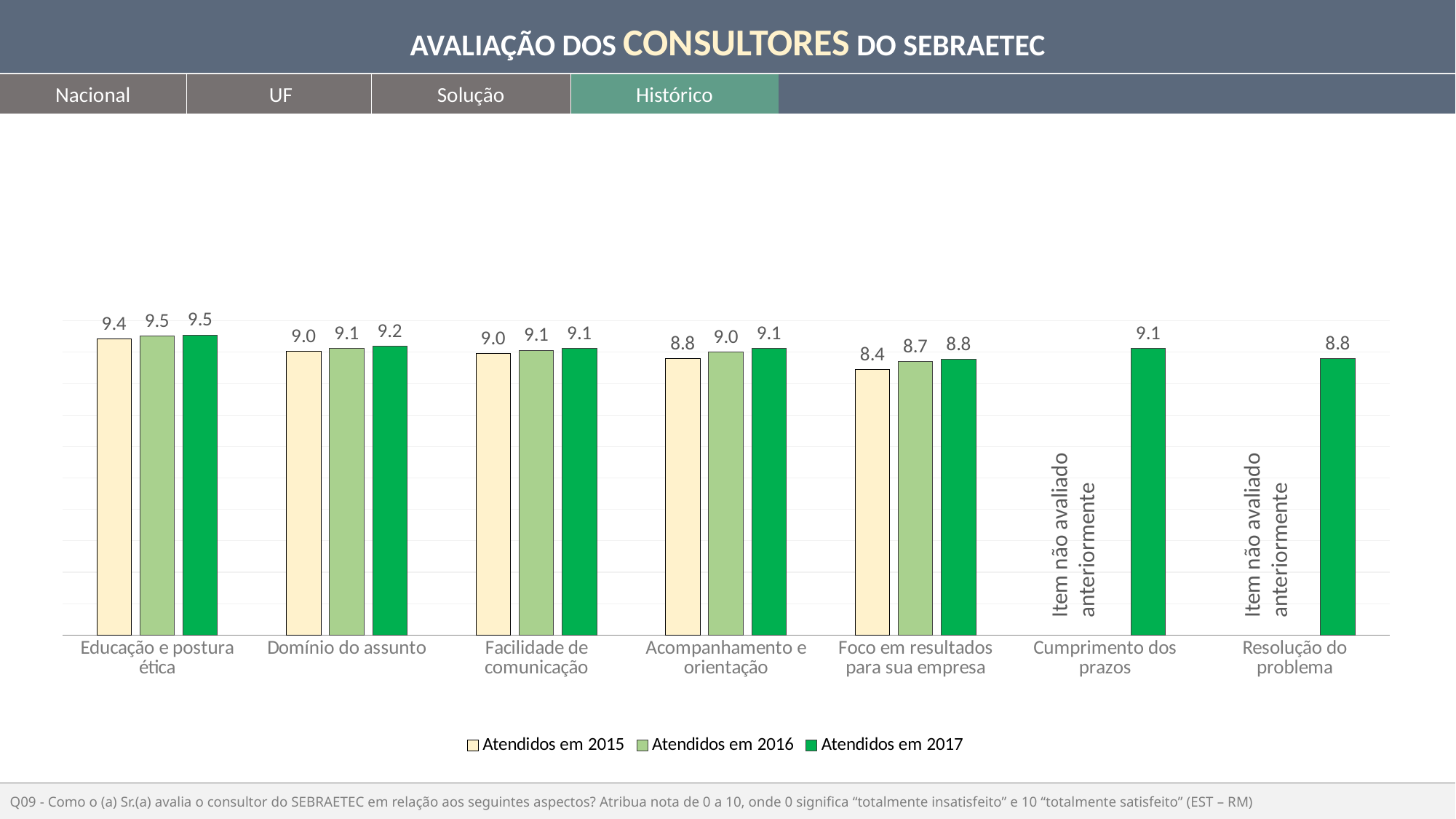
What kind of chart is shown on the slide? Bar chart What is the value for "Atendidos em 2017" in the "Domínio do assunto" category? 9.2 Which is larger for "Acompanhamento e orientação": the "Atendidos em 2015" value or the "Atendidos em 2017" value? Atendidos em 2017 Which category has the lowest value for "Atendidos em 2015"? Foco em resultados para sua empresa What is the value for "Atendidos em 2015" in the "Foco em resultados para sua empresa" category? 8.4 Which categories are marked as "Item não avaliado anteriormente" for the 2015 and 2016 series? Cumprimento dos prazos and Resolução do problema What is the value for "Atendidos em 2017" in the "Resolução do problema" category? 8.8 Which category has the highest value for "Atendidos em 2017"? Educação e postura ética What is the value for "Atendidos em 2016" in the "Acompanhamento e orientação" category? 9.0 What is the difference between the "Atendidos em 2017" and "Atendidos em 2015" values for "Foco em resultados para sua empresa"? 0.4 How many series does the legend list? 3 How many categories are shown on the x axis of the chart? 7